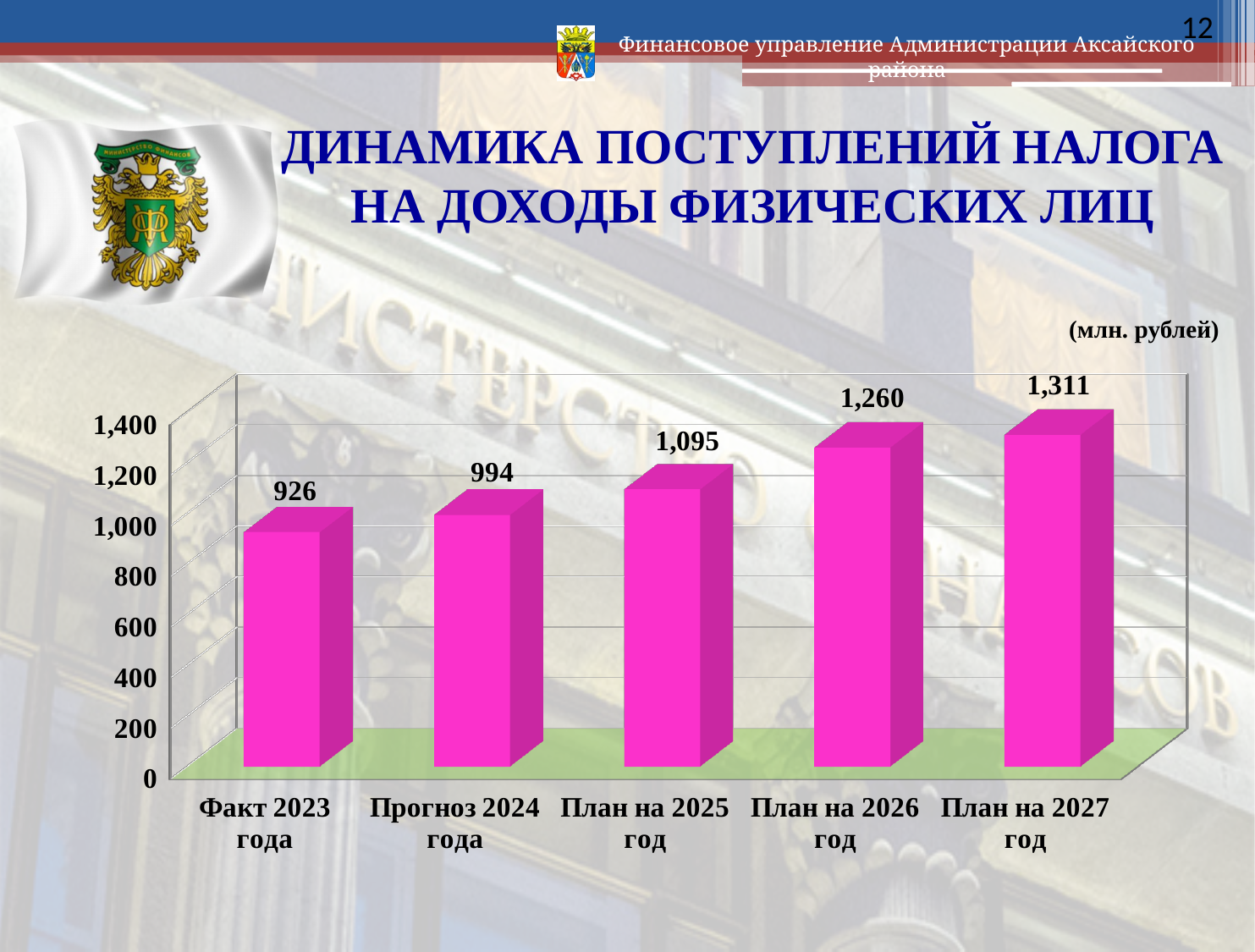
What is the value for Факт 2023 года? 926 What is the value for План на 2027 год? 1,311 How many categories are shown on the x axis? 5 What is the value for План на 2025 год? 1,095 Which category has the highest value? План на 2027 год What kind of chart is shown on the slide? Bar chart Do the values rise or fall from Факт 2023 года to План на 2027 год? Rise Which category has the lowest value? Факт 2023 года What is the value for Прогноз 2024 года? 994 What unit is indicated for the chart values? млн. рублей Which is larger, the value for Прогноз 2024 года or the value for План на 2025 год? План на 2025 год What is the difference between the values for План на 2026 год and План на 2025 год? 165